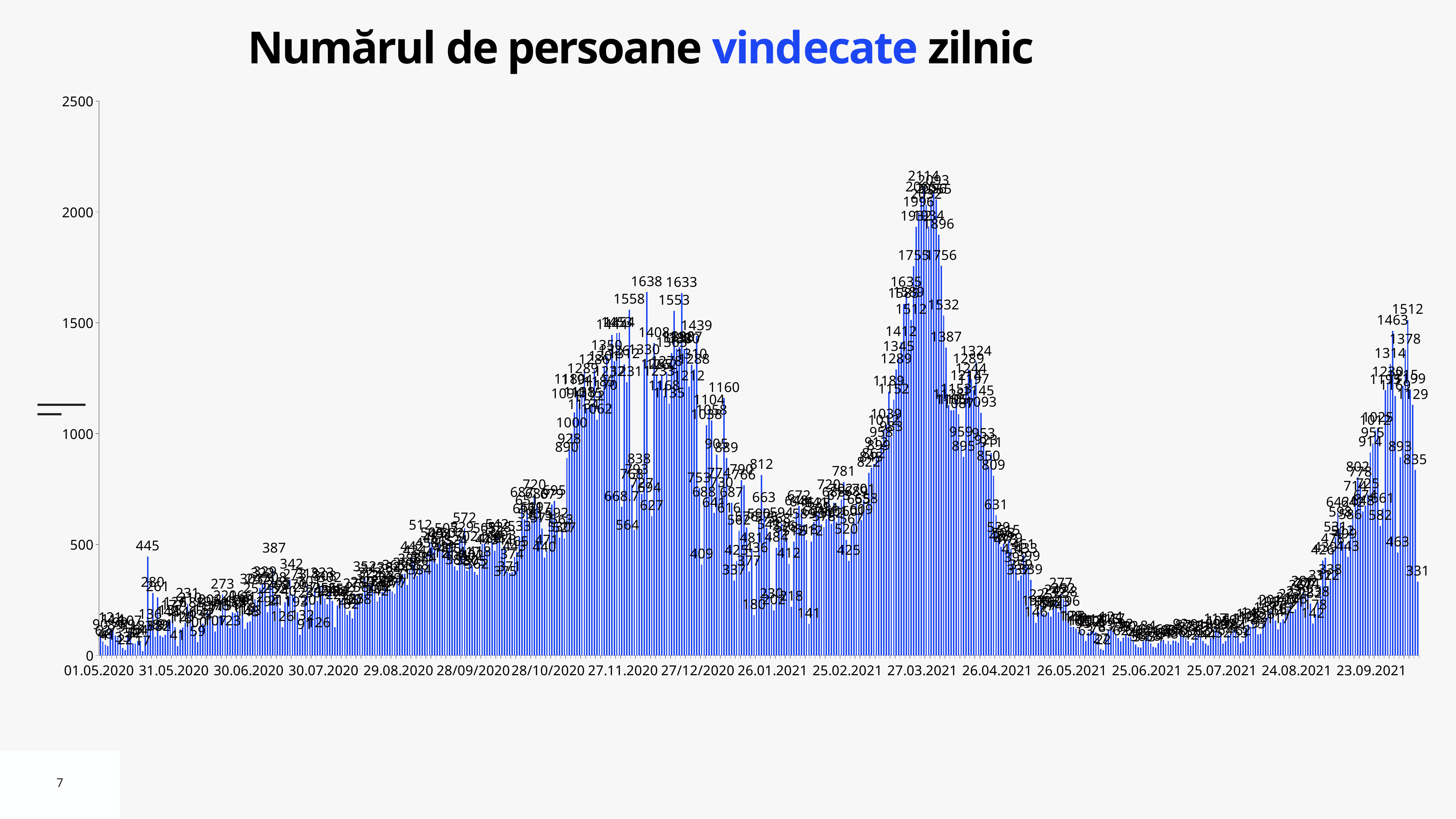
Is the value of the tallest bar near 27.03.2021 greater or less than 2000? greater What is the difference between the highest value of the March 2021 peak (2114) and the highest value of the November 2020 peak (1638)? 476 Do the values rise or fall between the 26.04.2021 and 26.05.2021 axis labels? fall What is the title of the chart? Numărul de persoane vindecate zilnic What is the value of the tallest bar between the 01.05.2020 and 31.05.2020 axis labels? 445 Near which x-axis date label does the chart reach its highest value? 27.03.2021 What is the value of the tallest bar between the 30.06.2020 and 30.07.2020 axis labels? 387 What is the highest value labelled in the peak around 27.11.2020? 1638 What kind of chart is shown on the slide? bar chart What is the highest value labelled on the chart? 2114 What is the highest value labelled in the final rise near 23.09.2021? 1512 Which peak is higher: the one around 27.03.2021 or the one around 27.11.2020? 27.03.2021